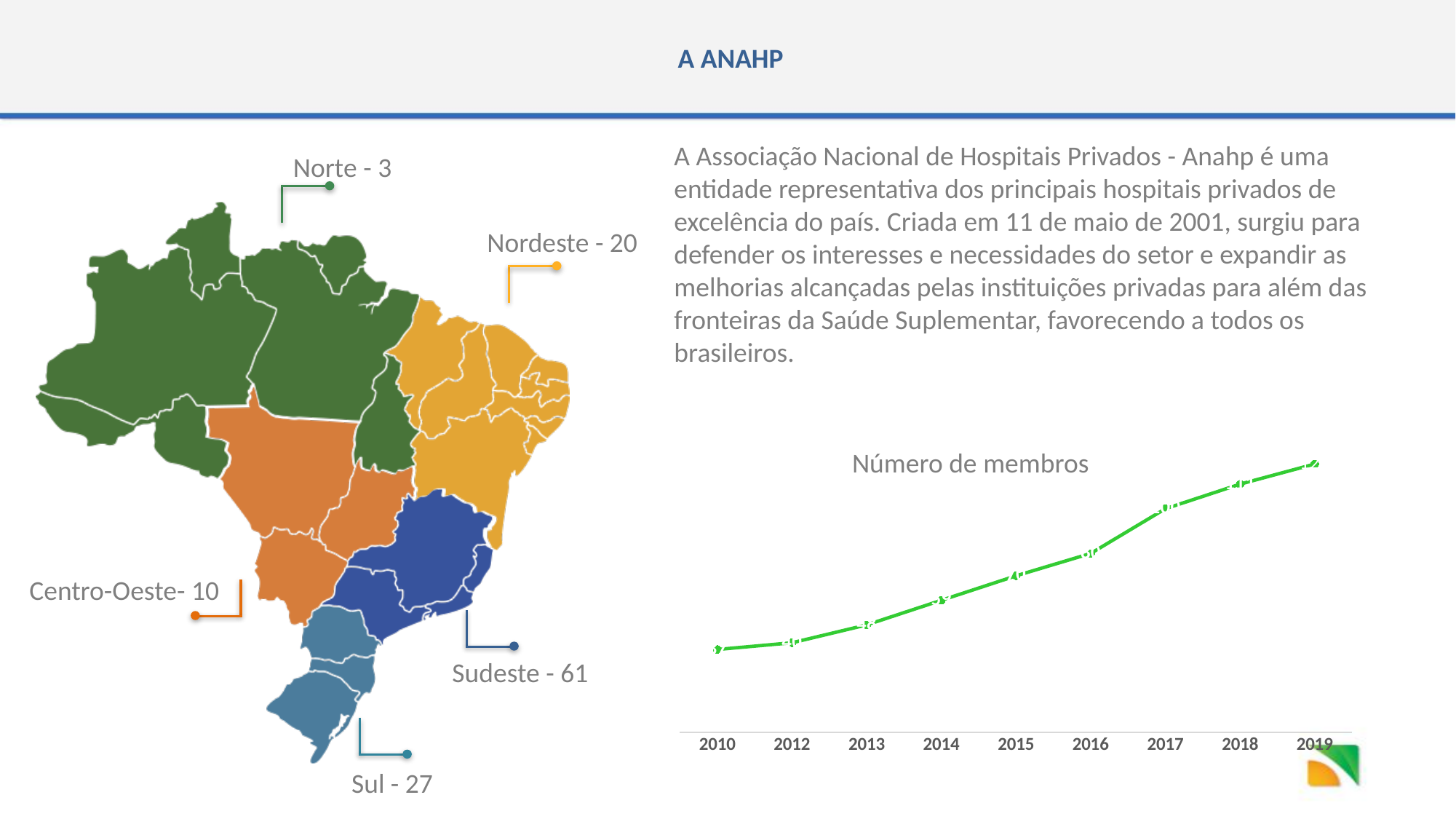
On the map on the left, what is the difference between the members in Sul and in Centro-Oeste? 17 What kind of chart is the 'Número de membros' chart? line chart In the 'Número de membros' chart, which year has the lowest value? 2010 In the 'Número de membros' chart, which year has the highest value? 2019 In the 'Número de membros' chart, do the values rise or fall from 2010 to 2019? rise On the map on the left, how many members are shown for Sudeste? 61 What is the first year shown on the x axis of the 'Número de membros' chart? 2010 On the map on the left, which region has the fewest members? Norte In the 'Número de membros' chart, which is larger: the value for 2012 or the value for 2018? 2018 In the 'Número de membros' chart, is the value for 2017 larger or smaller than the value for 2014? larger How many years are shown on the x axis of the 'Número de membros' chart? 9 What is the title of the chart on the right of the slide? Número de membros